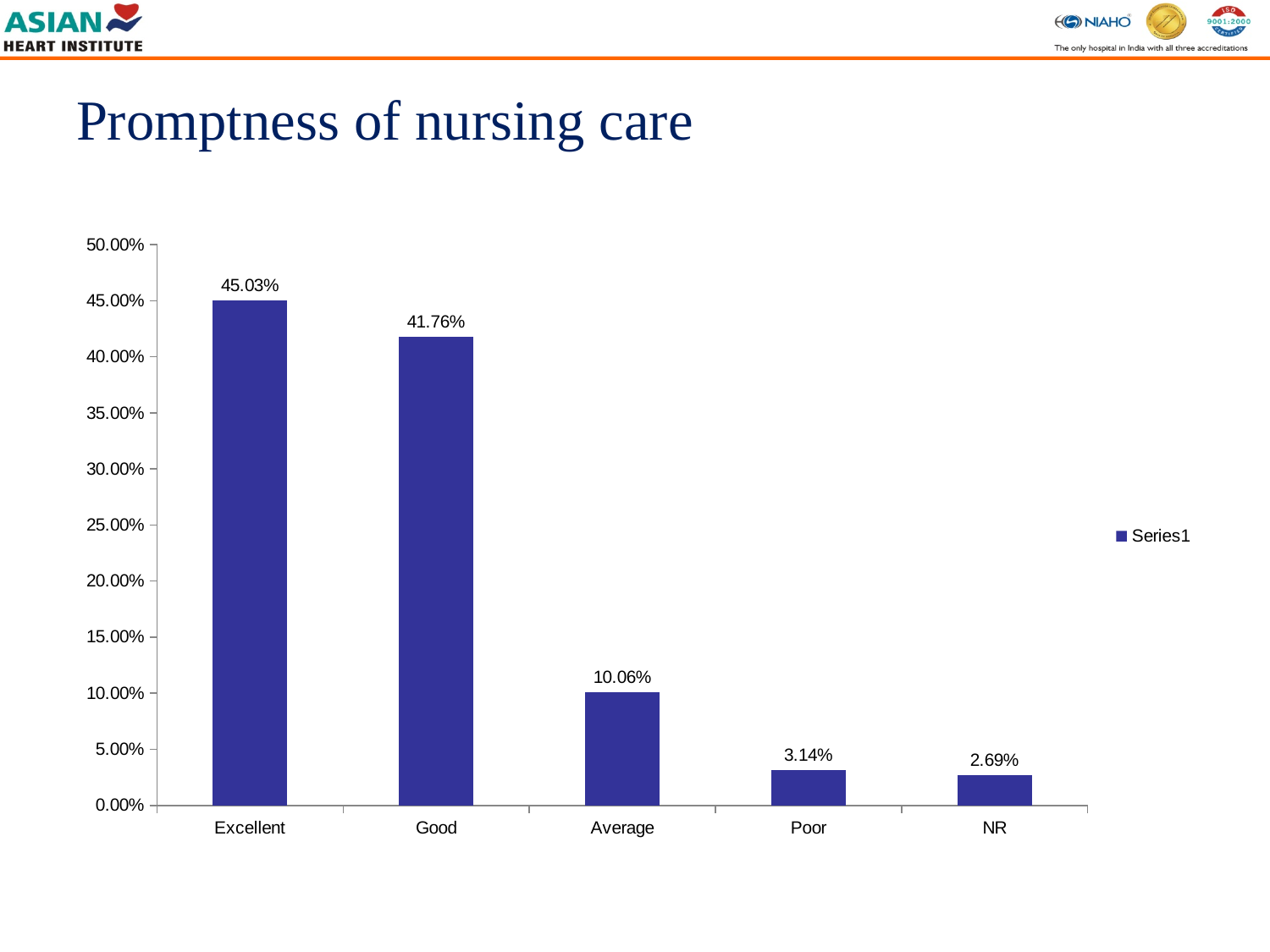
What is the value for NR? 2.69% What is the difference between the values for Average and Poor? 6.92% How many categories are shown on the x axis? 5 Is the value for Good greater or less than 40.00%? greater Which category has the highest value? Excellent What is the difference between the values for Excellent and Good? 3.27% What kind of chart is shown on the slide? bar chart Which category has the lowest value? NR What is the value for Average? 10.06% What is the value for Excellent? 45.03% What is the title of the slide? Promptness of nursing care Which is larger, the value for Good or the value for Average? Good